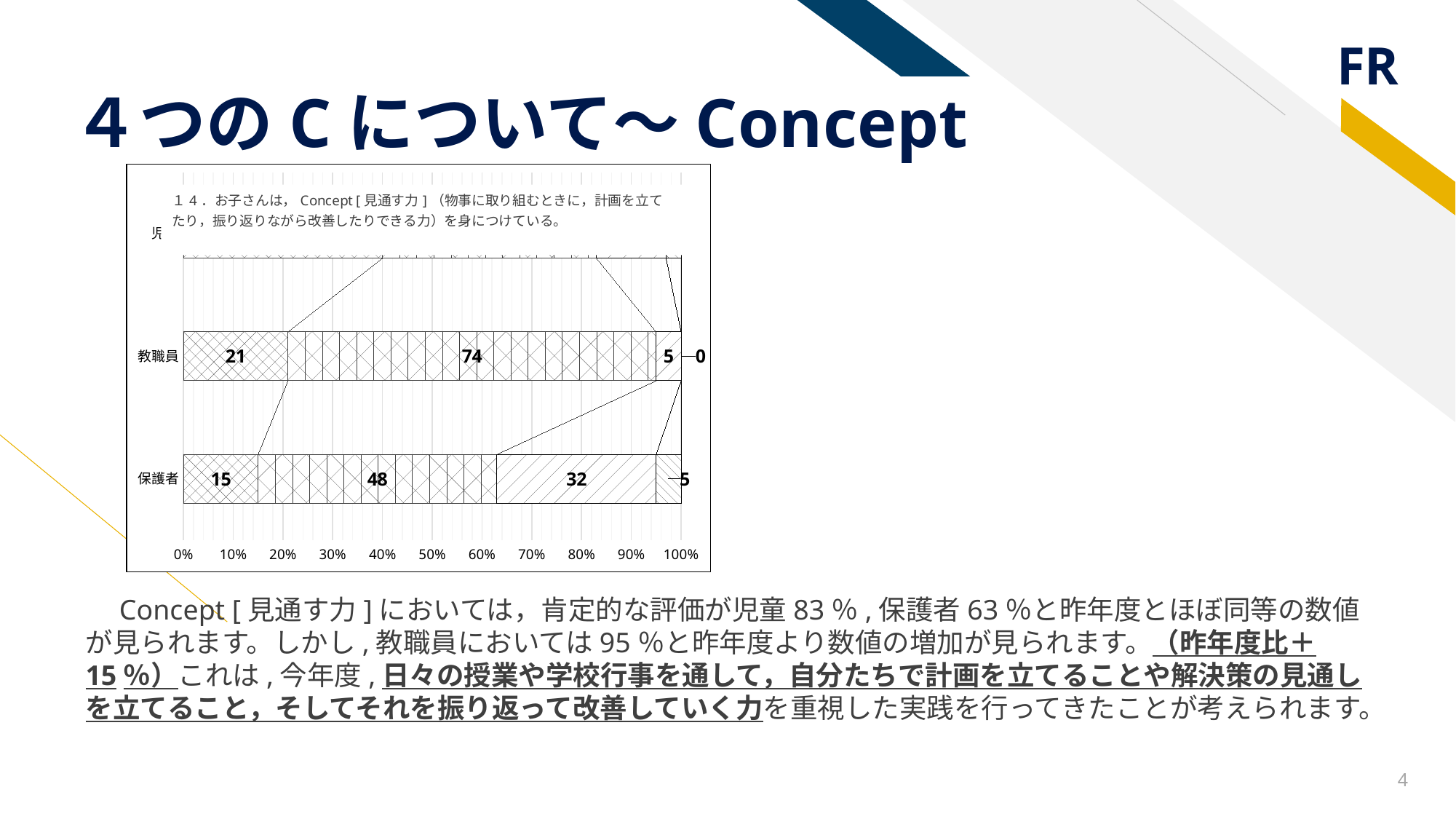
What is the value of the last segment of the 教職員 bar? 0 What is the value of the second segment of the 保護者 bar? 48 Which is larger: the second segment of the 教職員 bar or the second segment of the 保護者 bar? 教職員 What kind of chart is shown on the slide? stacked bar chart What is the value of the third segment of the 教職員 bar? 5 What is the value of the second segment of the 教職員 bar? 74 What is the total of the labelled segments in the 保護者 bar? 100 What is the value of the first (leftmost) segment of the 教職員 bar? 21 What is the value of the third segment of the 保護者 bar? 32 What is the value of the first (leftmost) segment of the 保護者 bar? 15 What is the difference between the second segment of the 教職員 bar (74) and the second segment of the 保護者 bar (48)? 26 What is the highest tick label shown on the horizontal axis? 100%